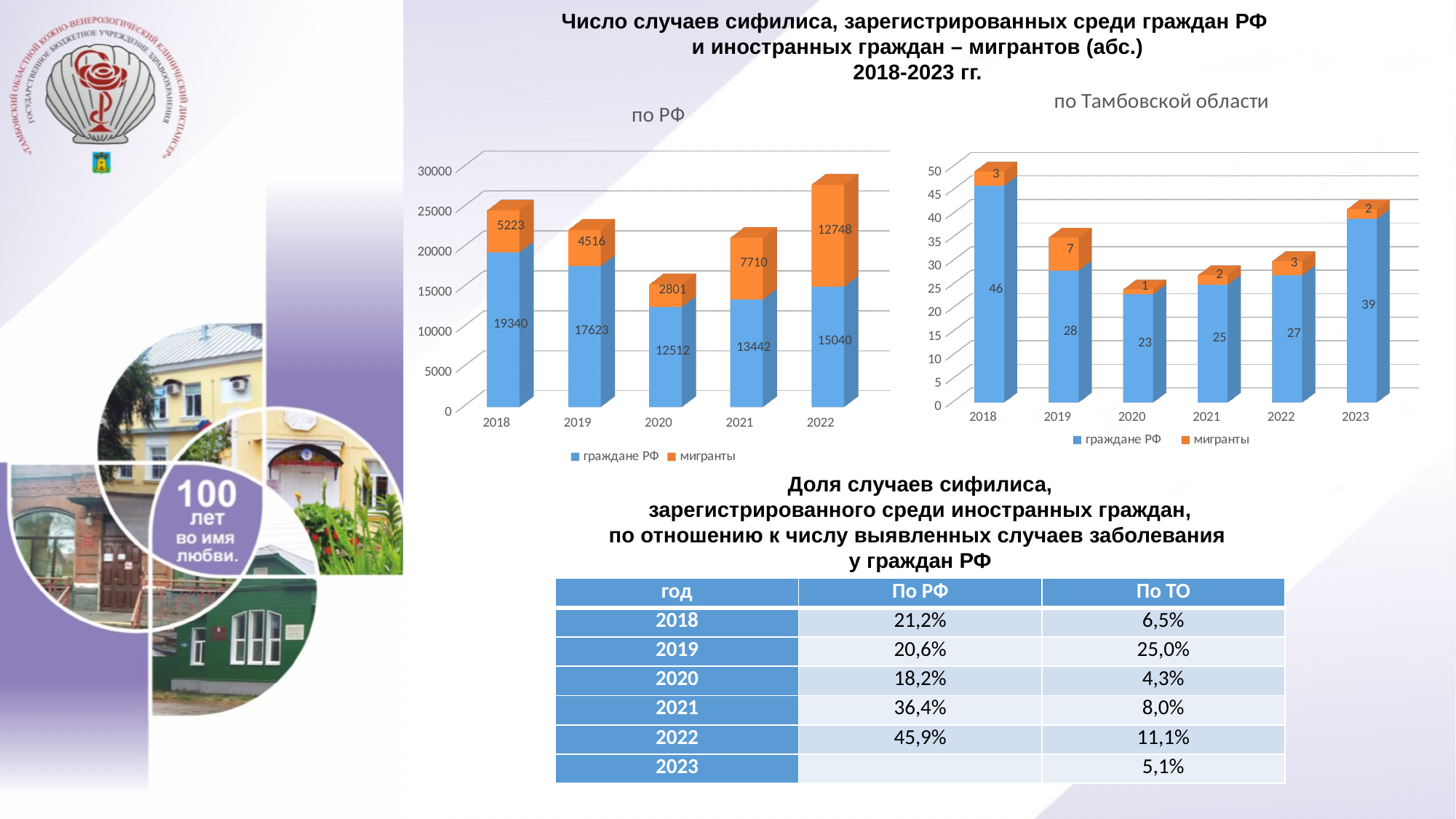
What kind of chart is the 'по РФ' chart? stacked bar chart In the 'по РФ' chart, what is the difference between граждане РФ in 2018 and in 2019? 1717 In the 'по Тамбовской области' chart, which year has the highest value for мигранты? 2019 In the 'по Тамбовской области' chart, what is the value for граждане РФ in 2023? 39 In the 'по Тамбовской области' chart, what is the total of the stacked bar for 2018? 49 In the 'по РФ' chart, which year has the highest value for граждане РФ? 2018 In the 'по РФ' chart, what is the value for мигранты in 2022? 12748 In the 'по РФ' chart, which year has the lowest value for мигранты? 2020 In the 'по Тамбовской области' chart, is the value for граждане РФ in 2022 larger or smaller than in 2021? larger In the 'по РФ' chart, what is the total of the stacked bar for 2022? 27788 In the 'по РФ' chart, what is the value for граждане РФ in 2020? 12512 In the 'по Тамбовской области' chart, how many years are shown on the x axis? 6